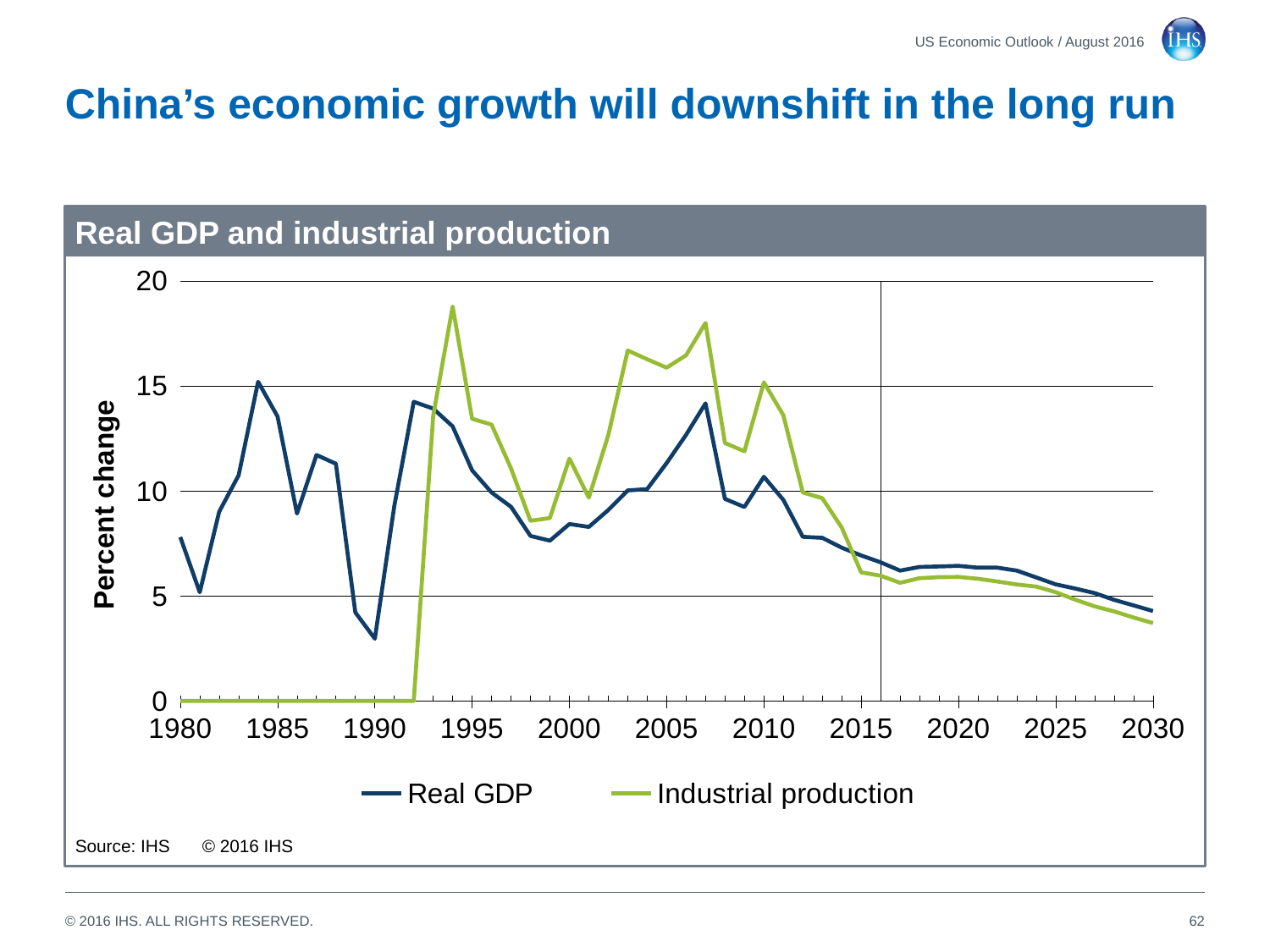
What is the label on the vertical axis of the chart? Percent change How many series does the legend list? 2 In 2030, which series has the higher value, Real GDP or Industrial production? Real GDP What kind of chart is shown on the slide? line chart Which series reaches the highest value anywhere on the chart? Industrial production Is the value for Industrial production in 2030 greater or less than 5? less Does the Real GDP line rise or fall between 2015 and 2030? fall In 2010, which series has the higher value, Real GDP or Industrial production? Industrial production What is the title of the chart? Real GDP and industrial production Is the value for Real GDP in 1980 greater or less than 5? greater Is the value for Real GDP in 1990 greater or less than 5? less